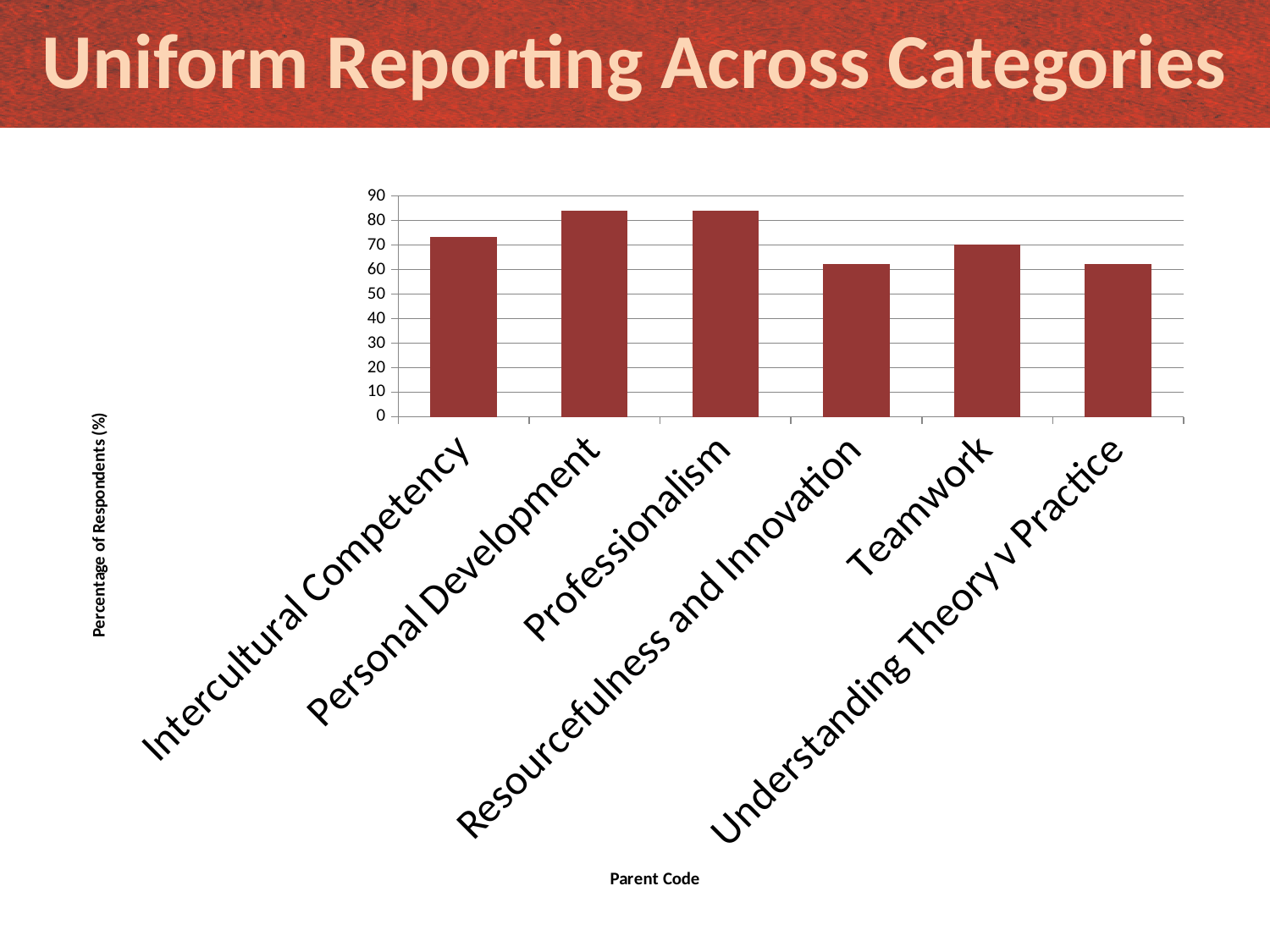
What kind of chart is shown on the slide? Bar chart Which has the larger value, Personal Development or Teamwork? Personal Development What is the label on the vertical axis of the chart? Percentage of Respondents (%) Is the value for Intercultural Competency greater or less than 60? greater What is the label on the horizontal axis of the chart? Parent Code Is the value for Resourcefulness and Innovation greater or less than 70? less Is the value for Understanding Theory v Practice greater or less than 70? less Which has the larger value, Intercultural Competency or Resourcefulness and Innovation? Intercultural Competency How many categories are shown on the x axis of the chart? 6